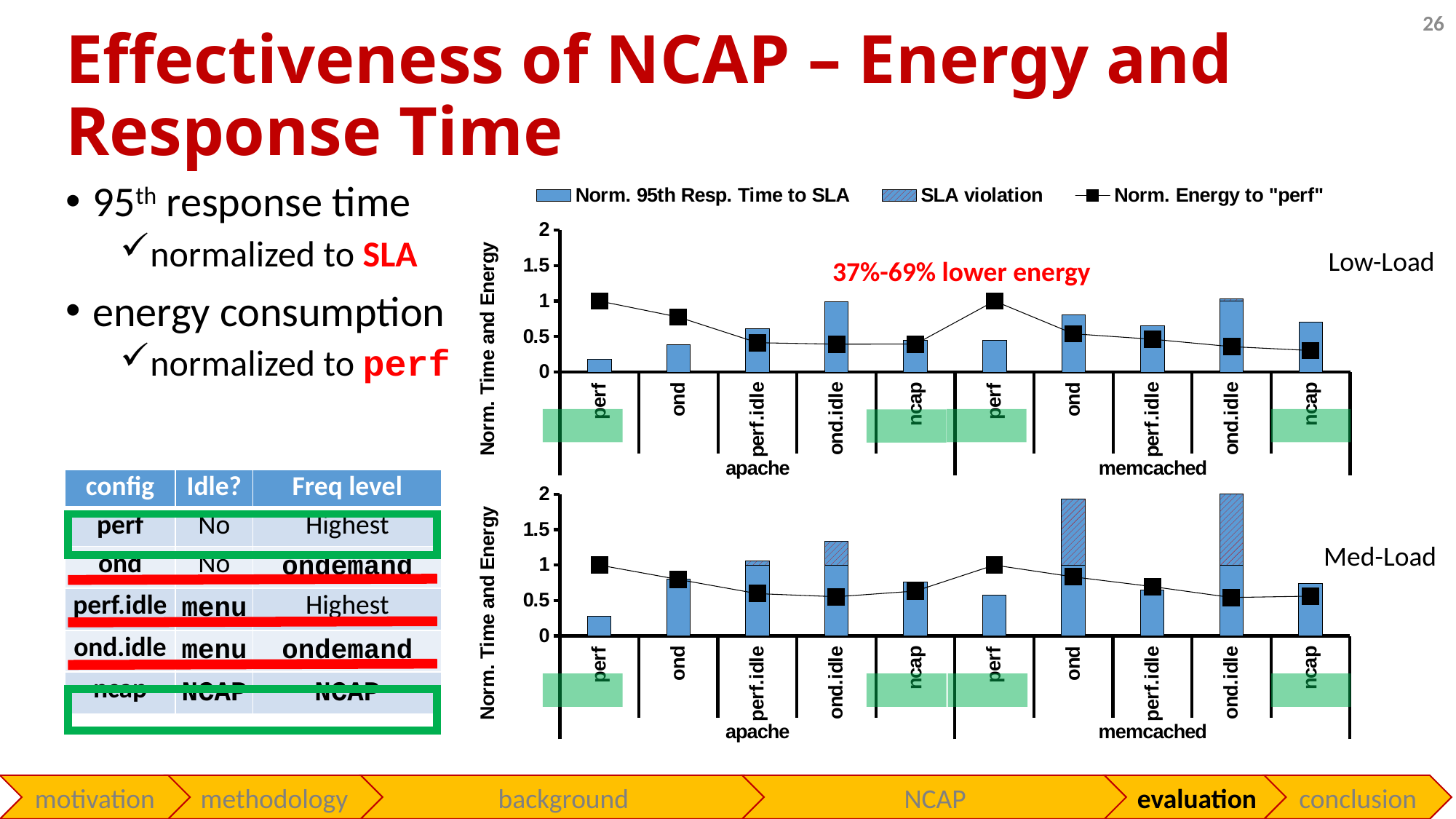
In the Low-Load chart, is the Norm. 95th Resp. Time bar for apache perf greater or less than 0.5? less In the Low-Load chart, how many configuration bars are plotted in total across apache and memcached? 10 How many series does the legend list for the charts? 3 What annotation in red text is printed inside the Low-Load chart? 37%-69% lower energy In the Med-Load chart, which has the larger Norm. 95th Resp. Time bar: memcached ond or memcached ncap? memcached ond In the Low-Load chart, is the Norm. Energy marker for apache ncap greater or less than 0.5? less In the Low-Load chart, which has the larger Norm. 95th Resp. Time bar: apache perf.idle or apache perf? apache perf.idle What kind of chart is the Med-Load chart? Bar chart with a line series In the Low-Load chart, which configuration has the lowest Norm. 95th Resp. Time bar? apache perf In the Med-Load chart, which configuration has the lowest Norm. 95th Resp. Time bar? apache perf